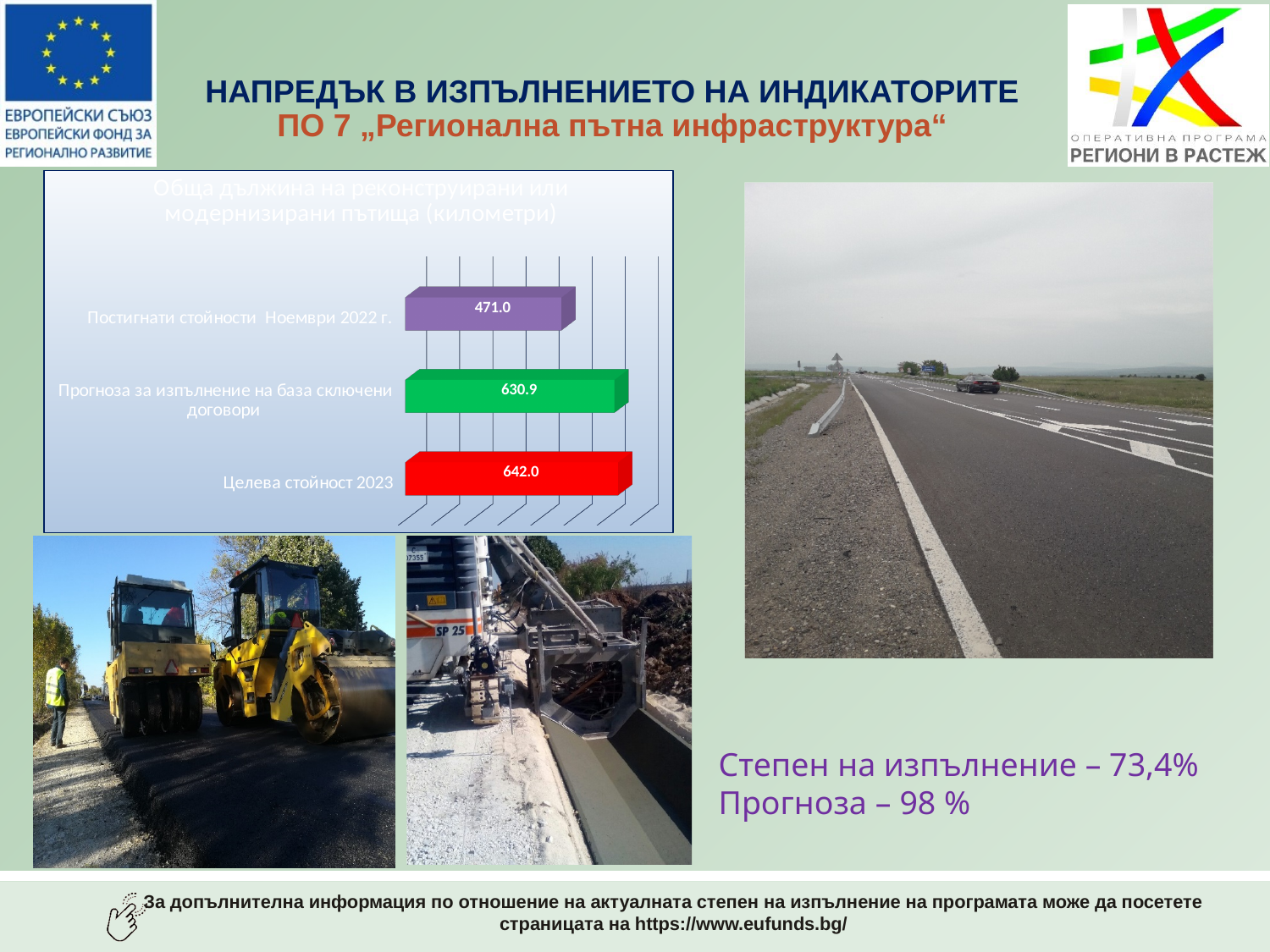
What kind of chart is shown on the slide? Bar chart What value is shown for "Целева стойност 2023" in the chart? 642.0 What is the difference between the value for "Целева стойност 2023" and the value for "Прогноза за изпълнение на база сключени договори"? 11.1 What colour is the bar for "Постигнати стойности Ноември 2022 г."? Purple How many categories (bars) does the chart show? 3 Which category has the lowest value in the chart? Постигнати стойности Ноември 2022 г. Which category has the highest value in the chart? Целева стойност 2023 What value is shown for "Прогноза за изпълнение на база сключени договори" in the chart? 630.9 What value is shown for "Постигнати стойности Ноември 2022 г." in the chart? 471.0 Which is larger: the value for "Прогноза за изпълнение на база сключени договори" or the value for "Постигнати стойности Ноември 2022 г."? Прогноза за изпълнение на база сключени договори What is the difference between the value for "Целева стойност 2023" and the value for "Постигнати стойности Ноември 2022 г."? 171.0 What colour is the bar for "Целева стойност 2023"? Red